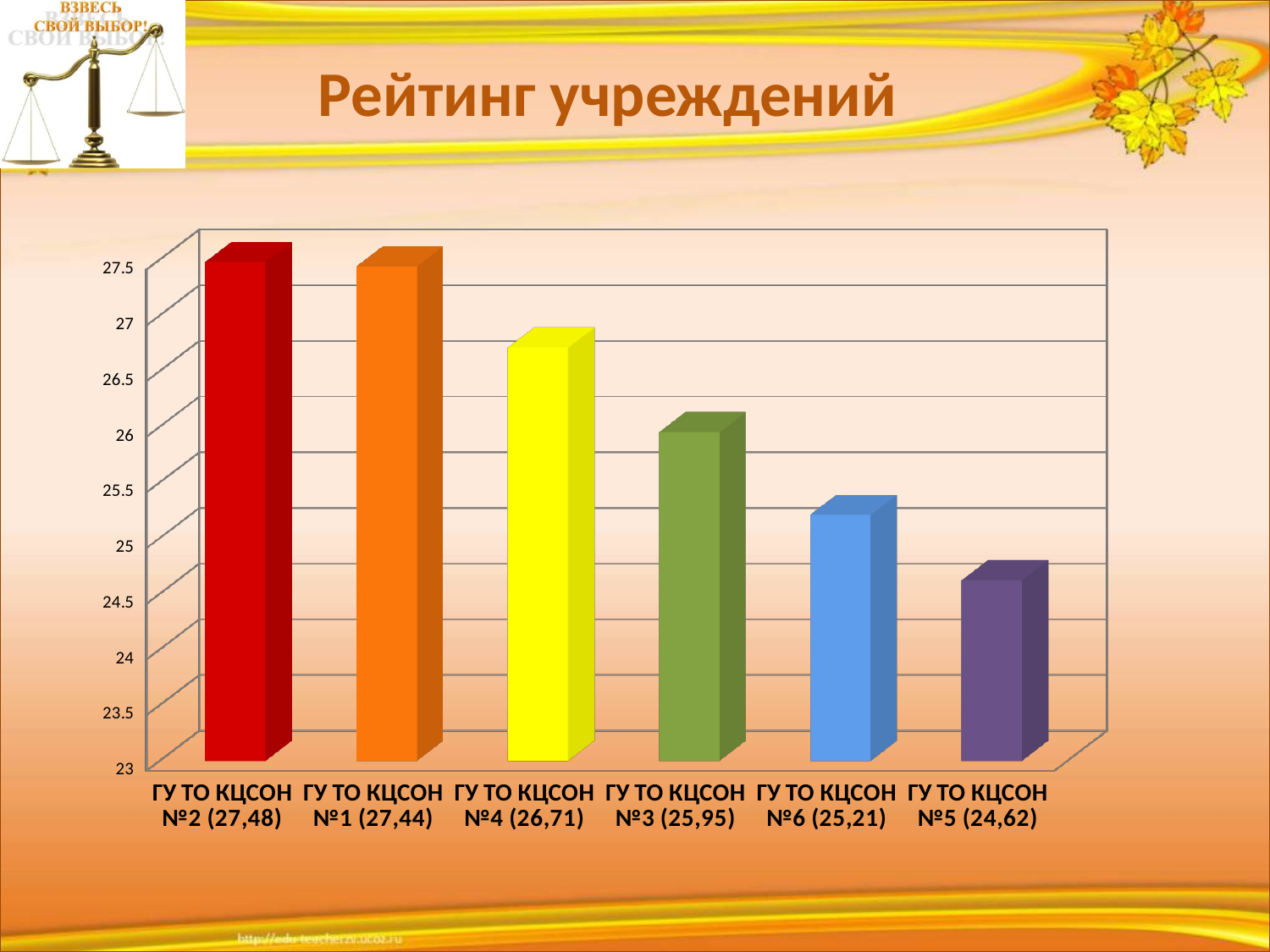
What is the difference between the values for ГУ ТО КЦСОН №4 and ГУ ТО КЦСОН №3? 0,76 What value is shown for ГУ ТО КЦСОН №3? 25,95 What is the difference between the values for ГУ ТО КЦСОН №2 and ГУ ТО КЦСОН №5? 2,86 Which is larger, the value for ГУ ТО КЦСОН №3 or ГУ ТО КЦСОН №6? ГУ ТО КЦСОН №3 Is the value for ГУ ТО КЦСОН №5 greater or less than 25? less Which institution has the lowest value? ГУ ТО КЦСОН №5 What value is shown for ГУ ТО КЦСОН №4? 26,71 What kind of chart is shown on the slide? bar chart How many institutions are shown in the chart? 6 Which institution has the highest value? ГУ ТО КЦСОН №2 What is the title of the slide? Рейтинг учреждений What value is shown for ГУ ТО КЦСОН №6? 25,21